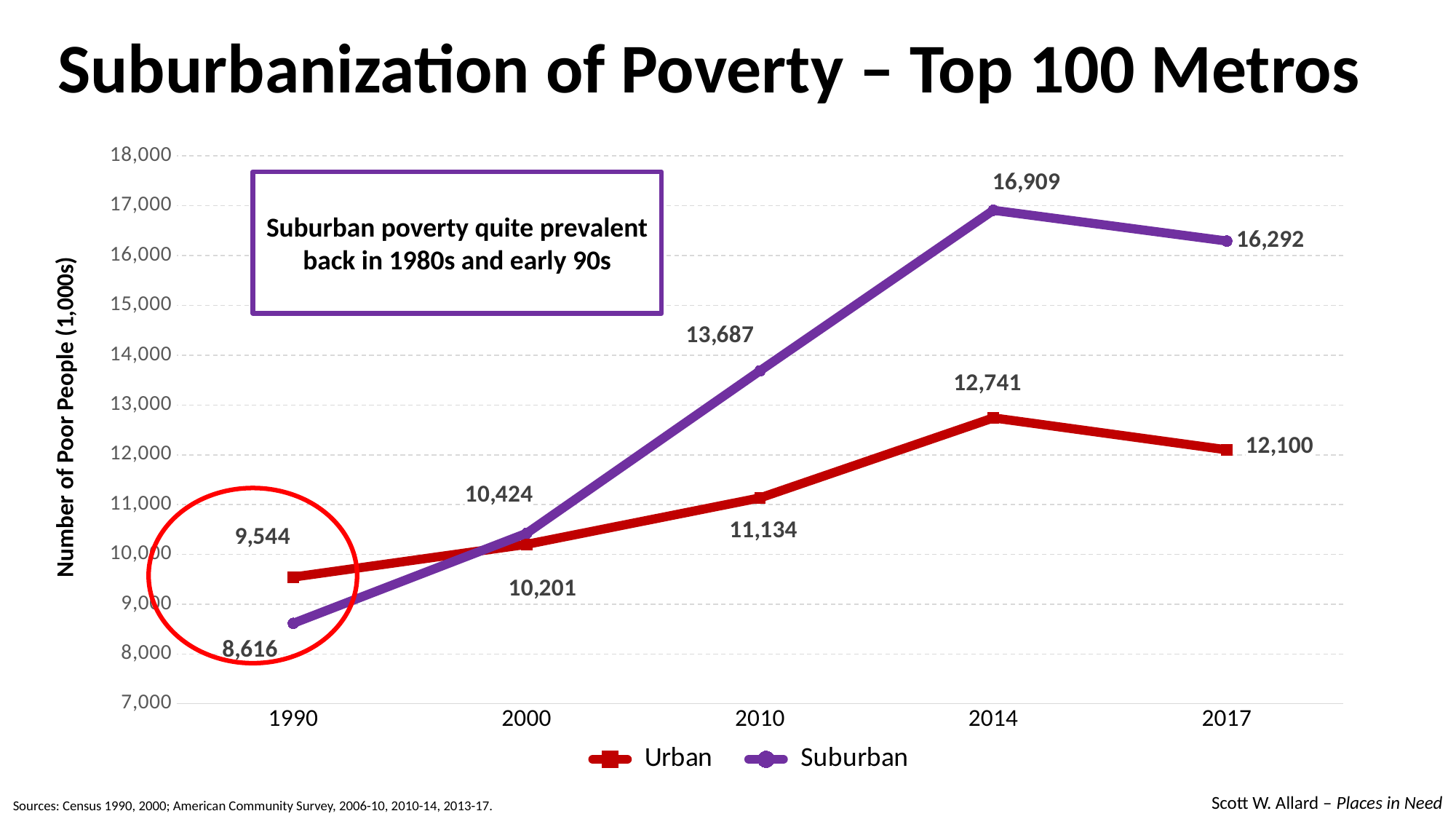
By how much did the Suburban value increase from 1990 to 2014? 8,293 In 1990, which series has the larger value, Urban or Suburban? Urban What is the Suburban value in 2014? 16,909 In which year is the Suburban series at its lowest? 1990 What kind of chart is shown on the slide? Line chart How many series does the legend list? 2 In which year is the Suburban series at its highest? 2014 Does the Suburban series rise or fall from 1990 to 2014? Rise What is the difference between the Suburban and Urban values in 2017? 4,192 What is the Urban value in 1990? 9,544 What is the Urban value in 2000? 10,201 How many years are shown on the x axis? 5